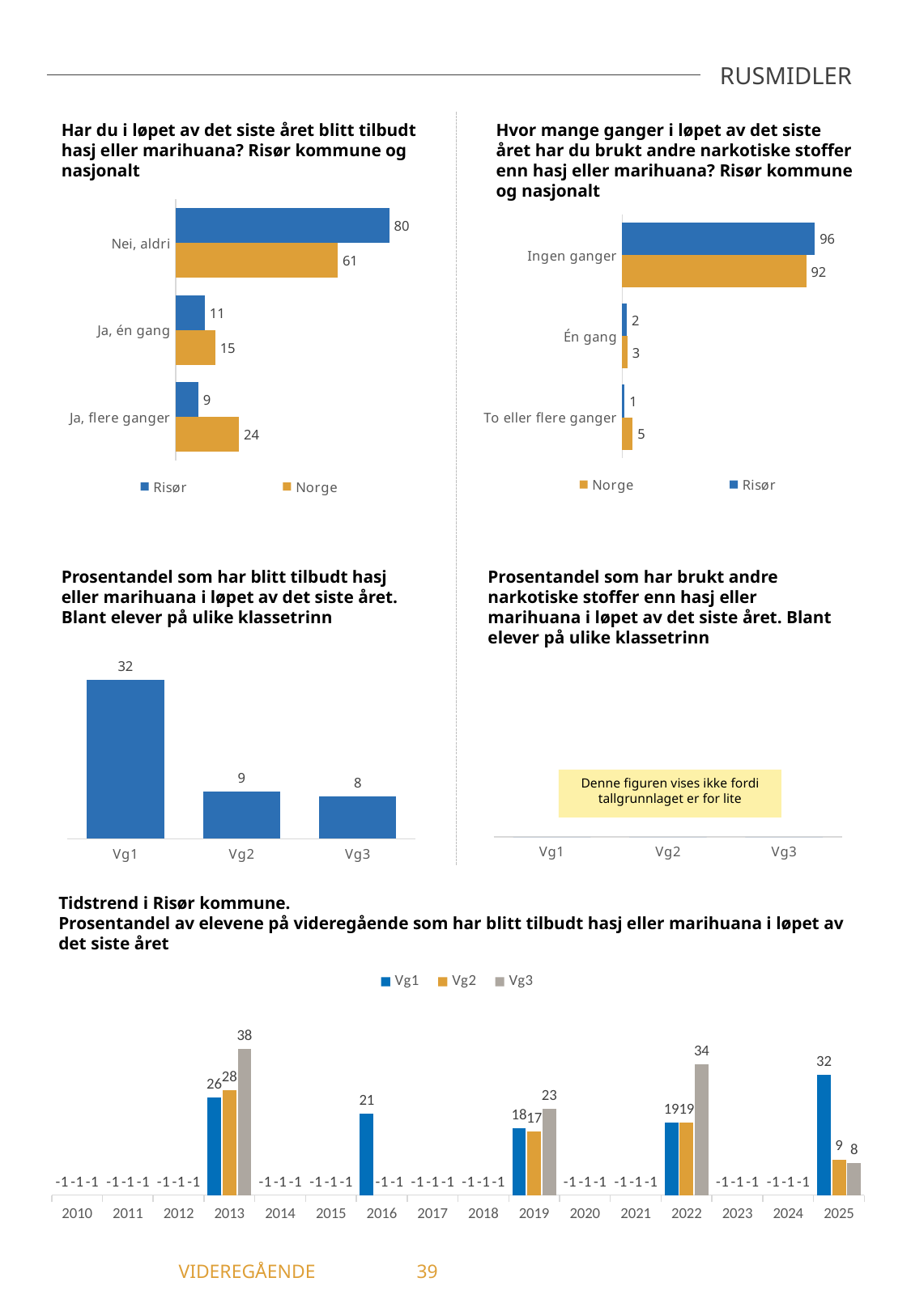
In the chart 'Tidstrend i Risør kommune', what is the value for Vg3 in 2013? 38 In the chart 'Tidstrend i Risør kommune', what is the value for Vg1 in 2016? 21 How many series does the legend list in the chart 'Hvor mange ganger i løpet av det siste året har du brukt andre narkotiske stoffer enn hasj eller marihuana?'? 2 In the chart 'Har du i løpet av det siste året blitt tilbudt hasj eller marihuana?', what is the value for Risør in the 'Nei, aldri' category? 80 What kind of chart is 'Prosentandel som har blitt tilbudt hasj eller marihuana i løpet av det siste året. Blant elever på ulike klassetrinn'? Bar chart In the chart 'Hvor mange ganger i løpet av det siste året har du brukt andre narkotiske stoffer enn hasj eller marihuana?', what is the value for Norge in the 'Ingen ganger' category? 92 In the chart 'Tidstrend i Risør kommune', what is the difference between the Vg1 and Vg2 values in 2025? 23 In the chart 'Har du i løpet av det siste året blitt tilbudt hasj eller marihuana?', what is the difference between the Norge and Risør values for 'Ja, flere ganger'? 15 In the chart 'Prosentandel som har blitt tilbudt hasj eller marihuana i løpet av det siste året. Blant elever på ulike klassetrinn', what is the value for Vg2? 9 In the chart 'Prosentandel som har blitt tilbudt hasj eller marihuana i løpet av det siste året. Blant elever på ulike klassetrinn', which class level has the highest value? Vg1 In the chart 'Har du i løpet av det siste året blitt tilbudt hasj eller marihuana?', which is larger for 'Ja, én gang': Risør or Norge? Norge In the chart 'Hvor mange ganger i løpet av det siste året har du brukt andre narkotiske stoffer enn hasj eller marihuana?', what is the value for Risør in 'To eller flere ganger'? 1